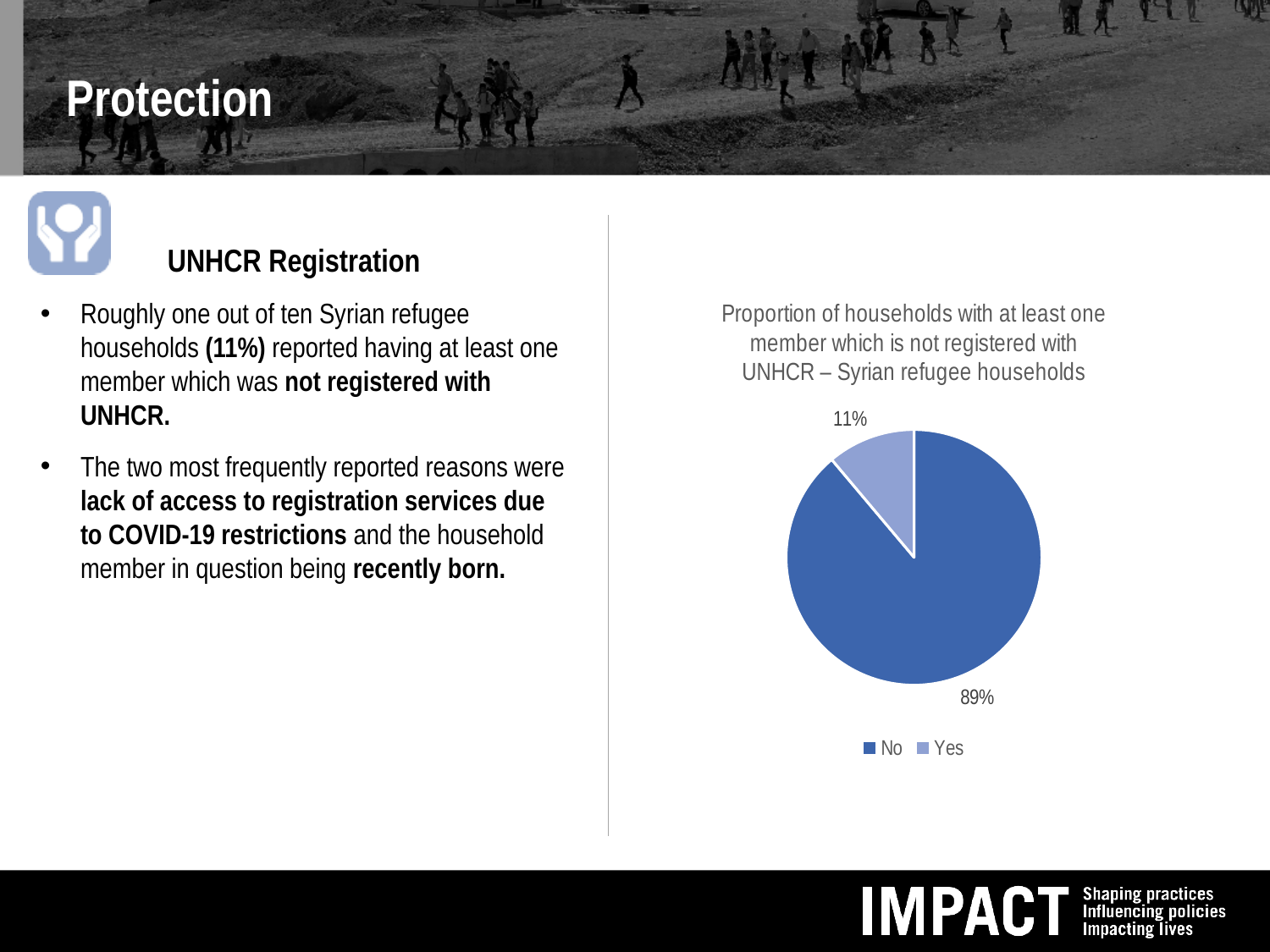
How many entries does the legend of the pie chart list? 2 Which slice is larger, "No" or "Yes"? No What kind of chart is shown on the slide? Pie chart How many categories does the pie chart show? 2 What is the title of the pie chart? Proportion of households with at least one member which is not registered with UNHCR – Syrian refugee households What percentage of households answered "Yes" in the pie chart? 11% What percentage of households answered "No" in the pie chart? 89% What share of the pie does the "Yes" slice represent? 11% What is the difference in percentage points between the "No" and "Yes" slices? 78 Which legend entry is shown in the lighter blue colour? Yes Which category has the smallest share of the pie chart? Yes Which category has the largest share of the pie chart? No